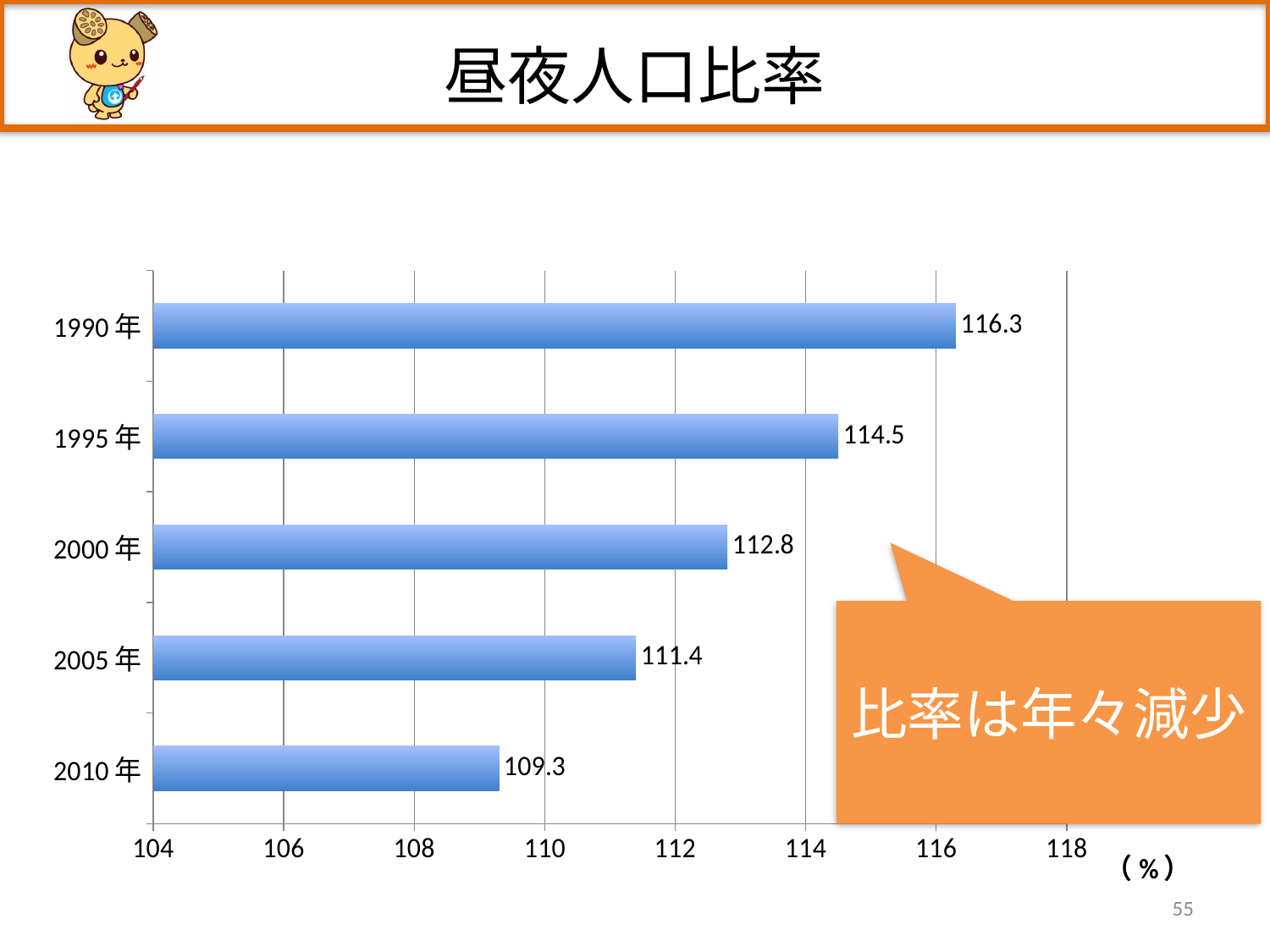
Is the value for 2005年 greater or less than 112? less Do the values rise or fall from 1990年 to 2010年? fall What is the value for 2000年? 112.8 How many years are shown in the chart? 5 What is the value for 1990年? 116.3 Which year has the lowest value? 2010年 Which year has the highest value? 1990年 What is the value for 2010年? 109.3 What is the difference between the values for 1995年 and 2005年? 3.1 What is the difference between the values for 1990年 and 2010年? 7.0 Which is larger, the value for 1995年 or the value for 2005年? 1995年 What kind of chart is shown on the slide? bar chart